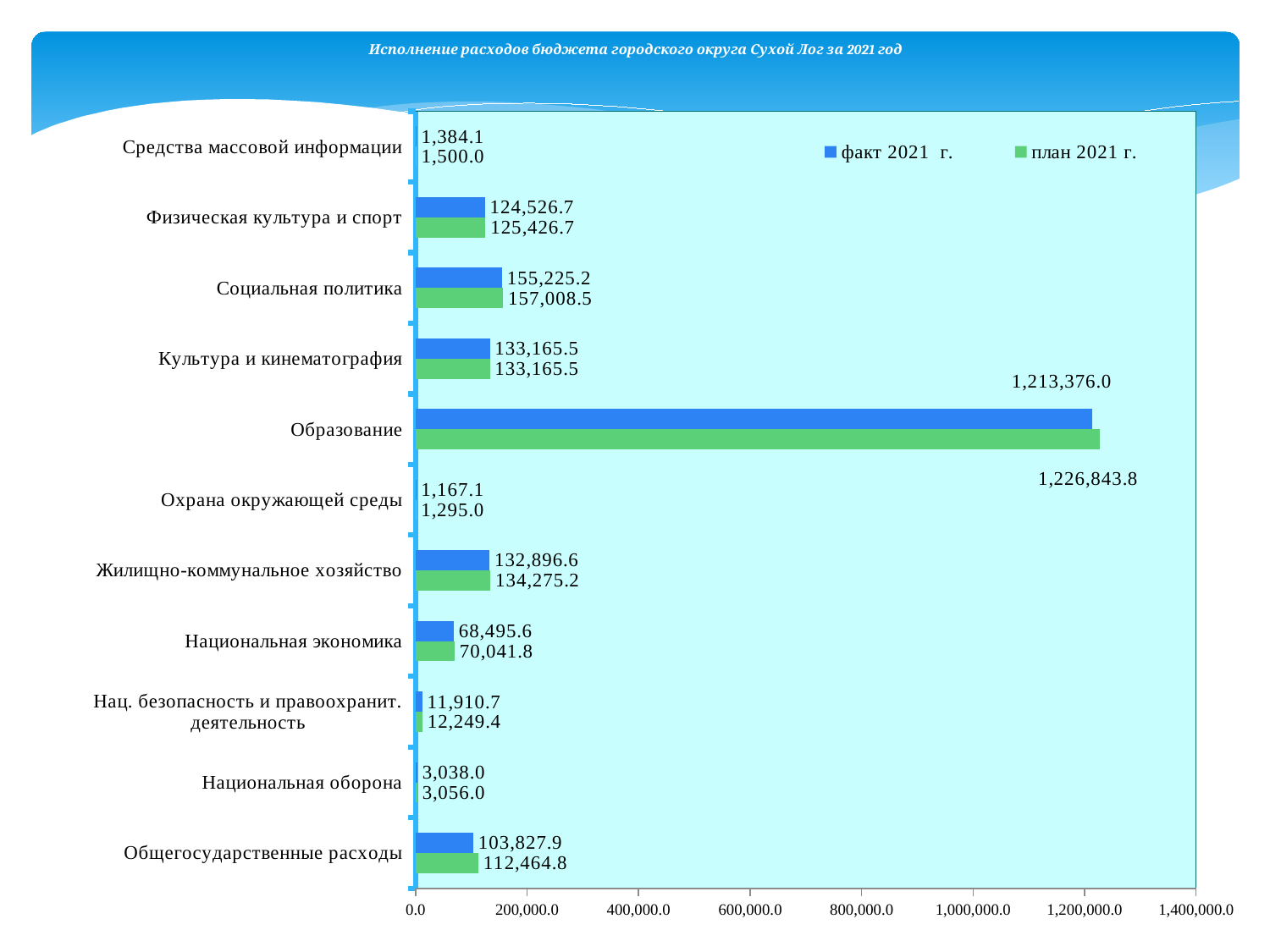
What colour are the bars for the план 2021 г. series? green How many categories are shown on the chart? 11 Which category has the highest факт 2021 г. value? Образование What is the факт 2021 г. value for Образование? 1,213,376.0 What is the план 2021 г. value for Общегосударственные расходы? 112,464.8 What kind of chart is shown on the slide? bar chart What is the факт 2021 г. value for Национальная оборона? 3,038.0 Which category has the lowest факт 2021 г. value? Охрана окружающей среды How many series does the legend list? 2 Which is larger: the факт 2021 г. value for Социальная политика or for Физическая культура и спорт? Социальная политика What is the difference between the план 2021 г. and факт 2021 г. values for Общегосударственные расходы? 8,636.9 What is the difference between the план 2021 г. and факт 2021 г. values for Образование? 13,467.8